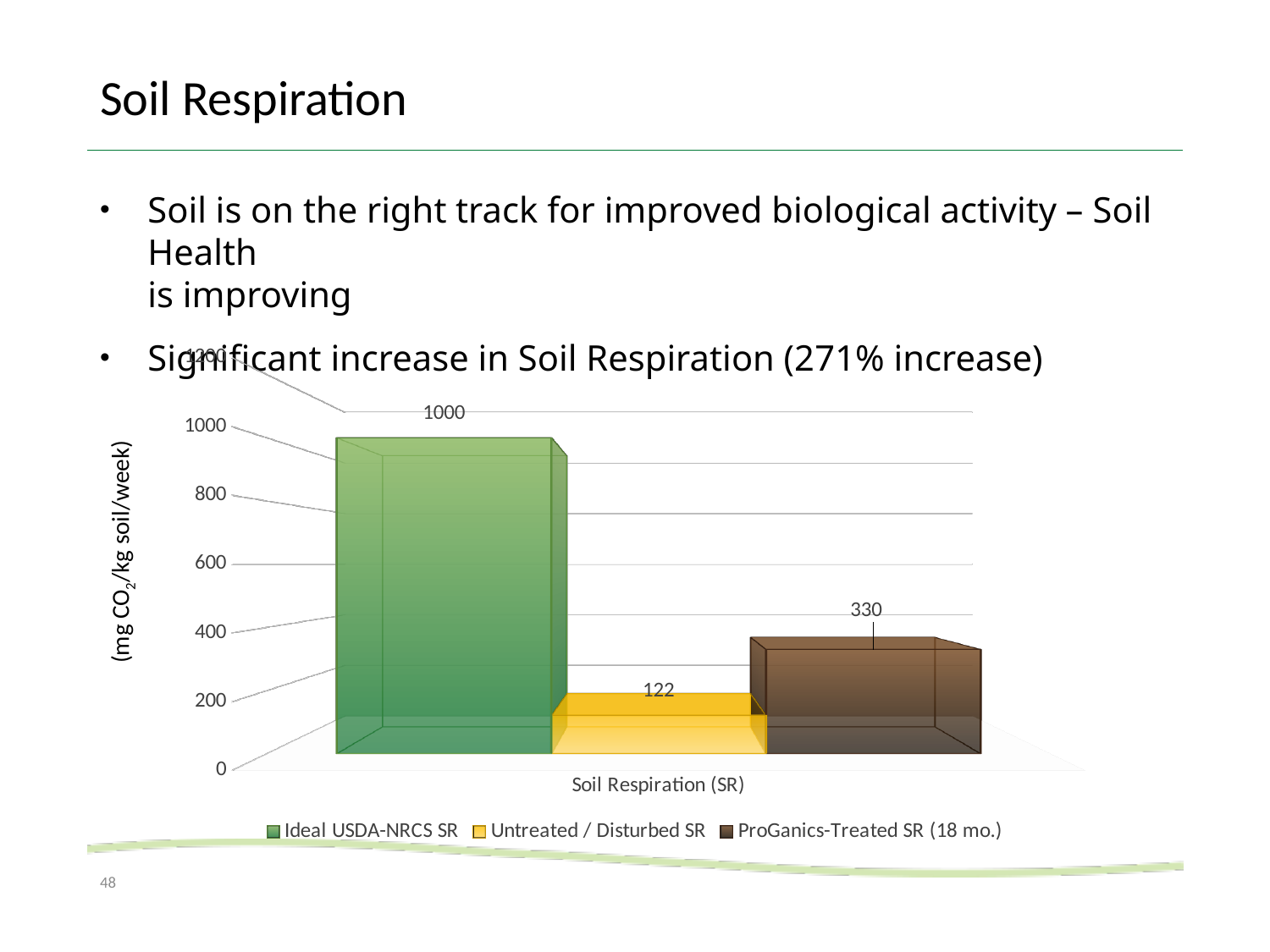
What is the difference between the Ideal USDA-NRCS SR value and the ProGanics-Treated SR (18 mo.) value? 670 Is the value for ProGanics-Treated SR (18 mo.) greater or less than 400? less What is the difference between the ProGanics-Treated SR (18 mo.) value and the Untreated / Disturbed SR value? 208 Which is larger, the value for ProGanics-Treated SR (18 mo.) or the value for Untreated / Disturbed SR? ProGanics-Treated SR (18 mo.) What is the label on the vertical axis of the chart? (mg CO2/kg soil/week) What is the value for Untreated / Disturbed SR? 122 What is the value for Ideal USDA-NRCS SR? 1000 Which series has the lowest value? Untreated / Disturbed SR How many series does the legend list? 3 Which series has the highest value? Ideal USDA-NRCS SR What is the value for ProGanics-Treated SR (18 mo.)? 330 What kind of chart is shown on the slide? bar chart